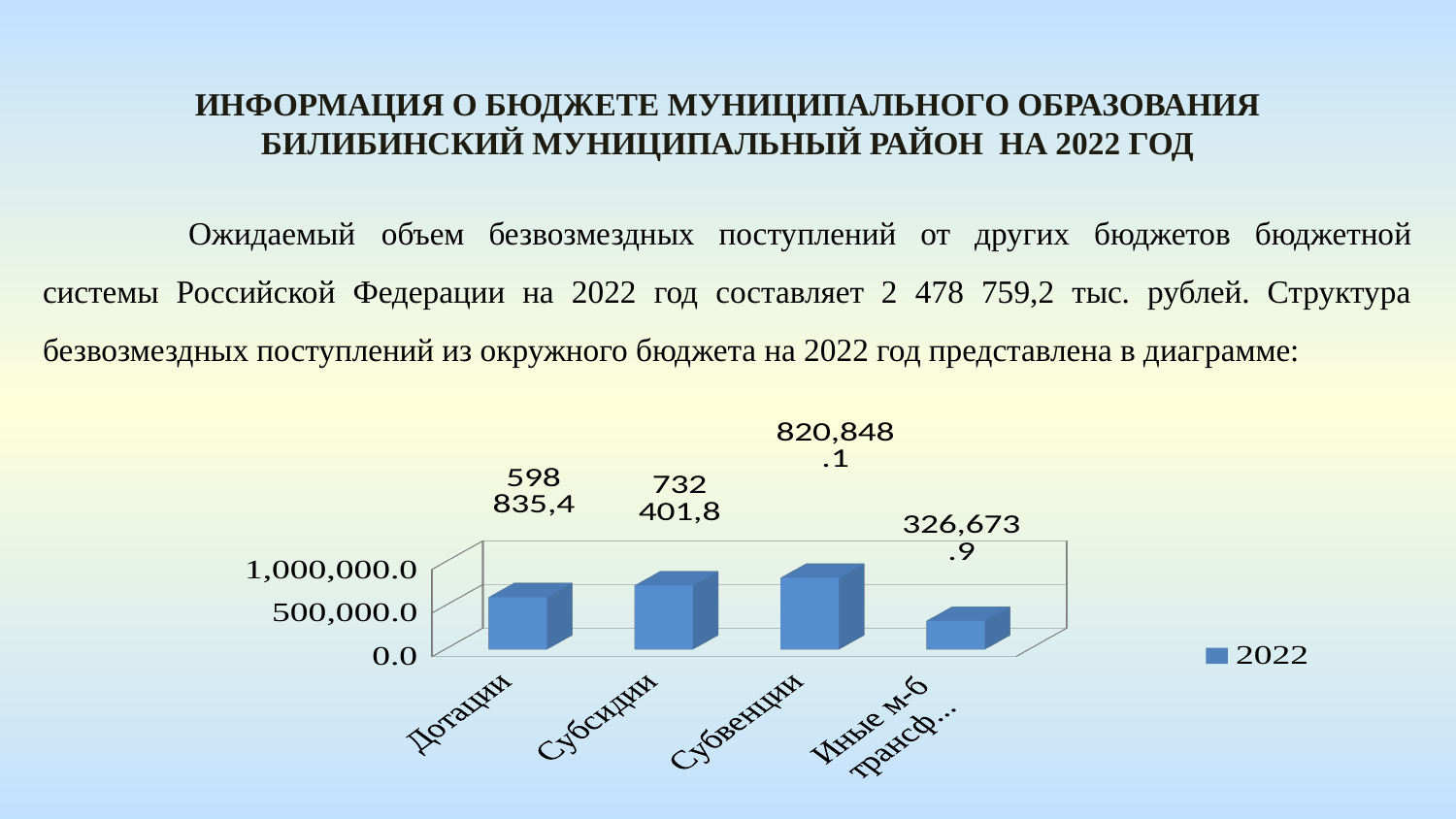
What value is shown for the rightmost bar (Иные м-б трансф...)? 326,673.9 What value is shown for Дотации? 598 835,4 How many series does the legend list? 1 What value is shown for Субвенции? 820,848.1 How many categories are shown on the chart? 4 Which category has the highest value? Субвенции What is the difference between the values for Субвенции and Субсидии? 88,446.3 Which category has the lowest value? Иные м-б трансф... What value is shown for Субсидии? 732 401,8 What kind of chart is shown on the slide? bar chart Which is larger, the value for Субсидии or the value for Дотации? Субсидии Is the value for Субвенции greater or less than 1,000,000.0? less